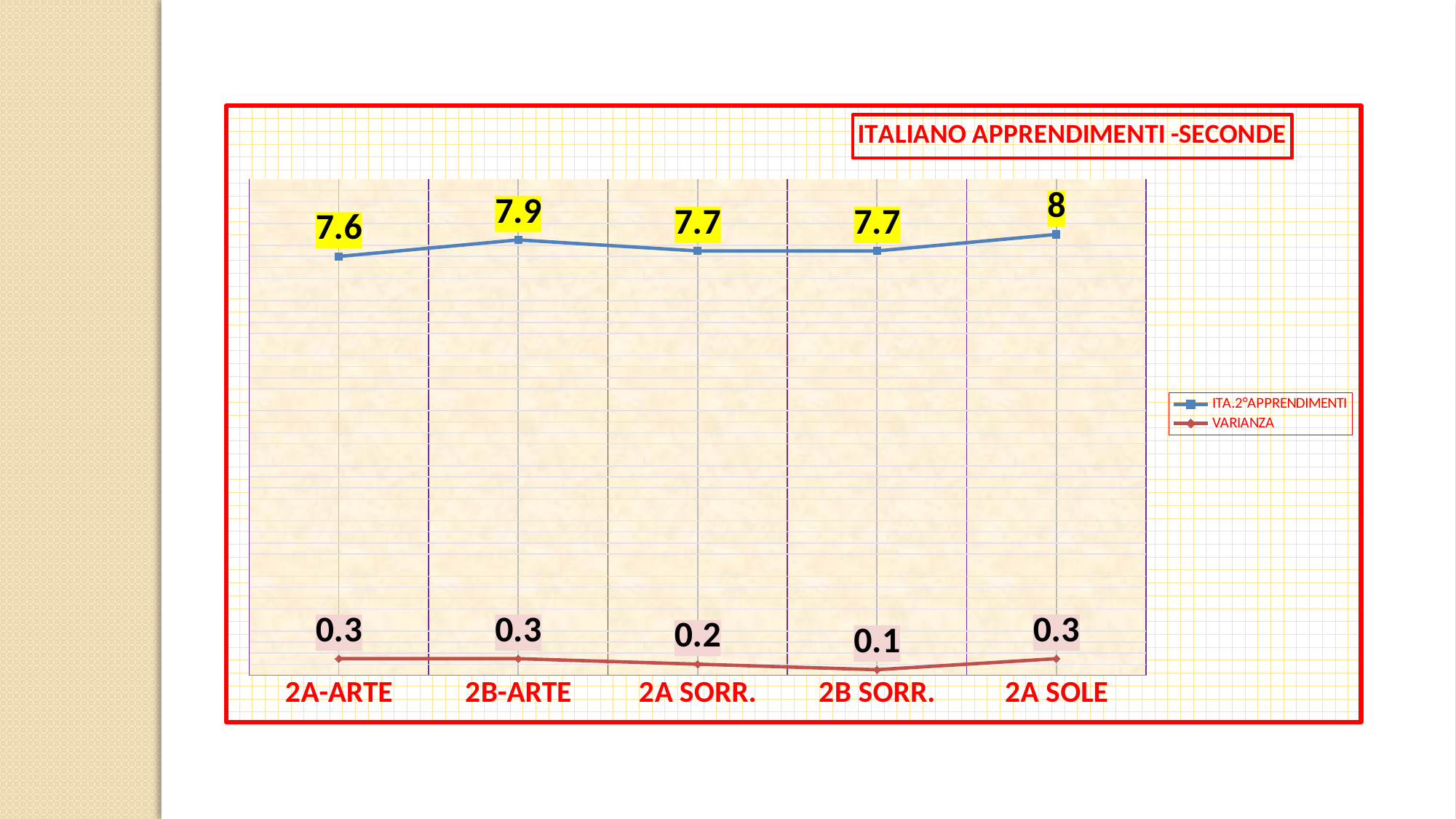
What is the ITA.2°APPRENDIMENTI value for 2A SOLE? 8 What is the VARIANZA value for 2B SORR.? 0.1 What kind of chart is shown? Line chart How many series does the legend list? 2 Which category has the highest ITA.2°APPRENDIMENTI value? 2A SOLE Which category has the lowest ITA.2°APPRENDIMENTI value? 2A-ARTE What is the title of the chart? ITALIANO APPRENDIMENTI -SECONDE What is the difference between the ITA.2°APPRENDIMENTI values for 2A SOLE and 2A-ARTE? 0.4 What is the ITA.2°APPRENDIMENTI value for 2B-ARTE? 7.9 How many categories are shown on the x axis? 5 Which is larger, the ITA.2°APPRENDIMENTI value for 2B-ARTE or for 2A SORR.? 2B-ARTE Which category has the lowest VARIANZA value? 2B SORR.